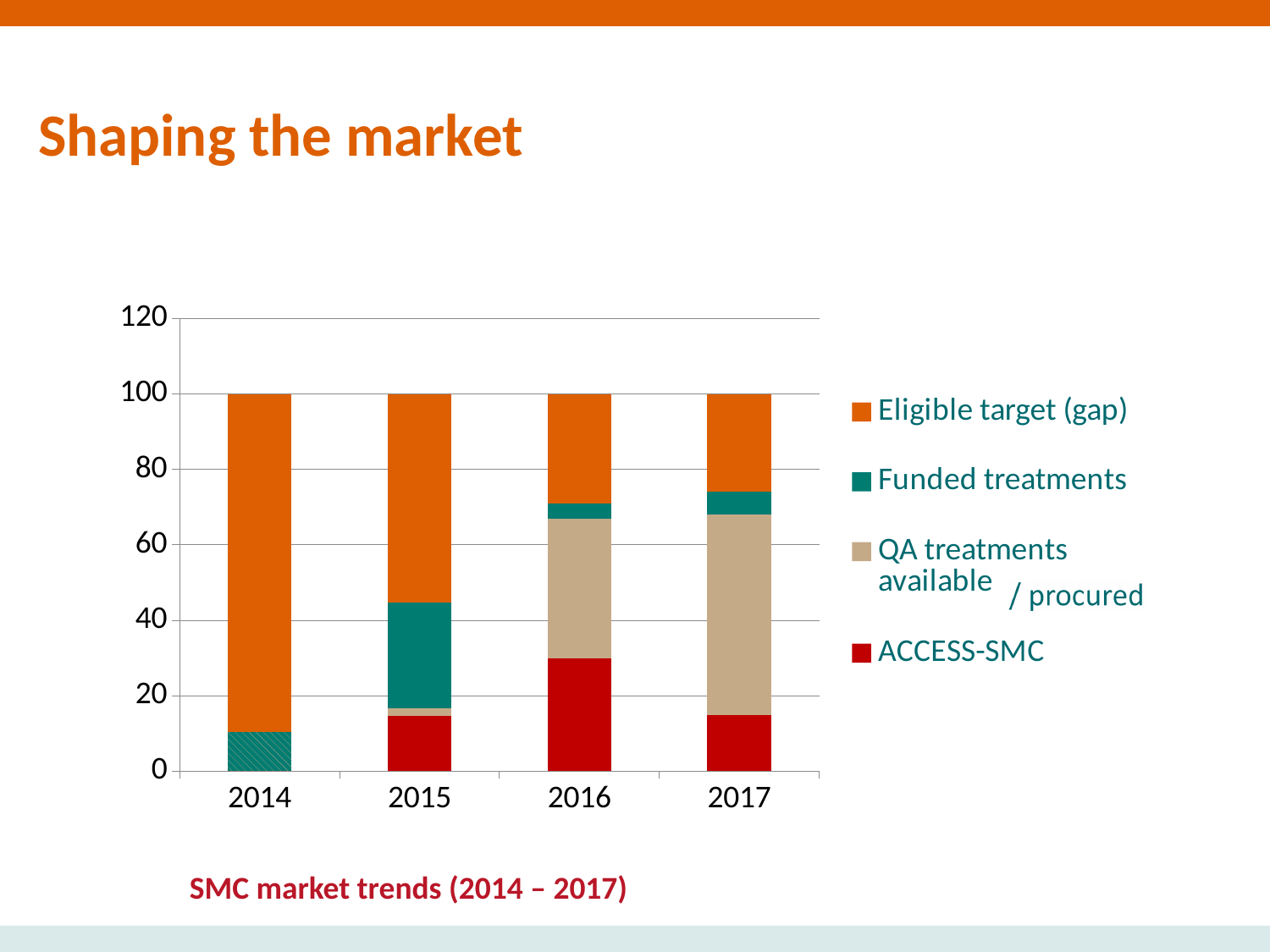
Which year has the largest QA treatments available / procured segment? 2017 Which year has the largest ACCESS-SMC segment? 2016 Is the ACCESS-SMC value for 2015 greater or less than 20? less What is the total height of the stacked bar for 2014? 100 How many years are shown on the x axis of the chart? 4 Does the Eligible target (gap) segment rise or fall from 2014 to 2017? Fall Is the ACCESS-SMC segment larger in 2016 or in 2017? 2016 Which year has the largest Eligible target (gap) segment? 2014 How many series does the chart's legend list? 4 Is the ACCESS-SMC value for 2016 greater or less than 20? greater What kind of chart is shown on the slide? Stacked bar chart What is the title shown beneath the chart? SMC market trends (2014 – 2017)